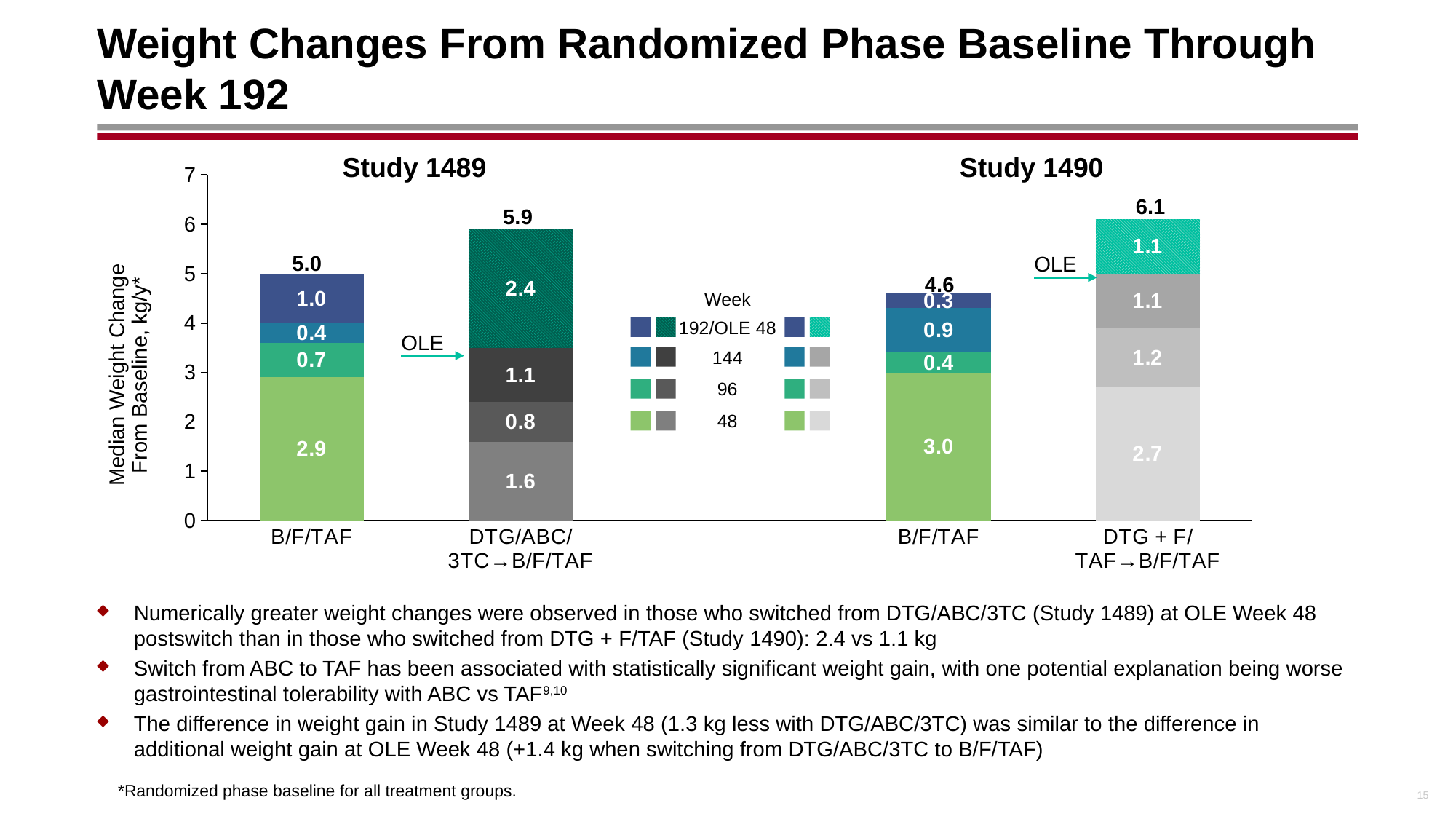
In the Study 1489 chart, what is the OLE Week 48 segment value for the DTG/ABC/3TC→B/F/TAF bar? 2.4 What type of chart is used on this slide? Stacked bar chart In the Study 1490 chart, what is the Week 144 segment value for the B/F/TAF bar? 0.9 In the Study 1490 chart, what is the Week 48 segment value for the B/F/TAF bar? 3.0 In the Study 1489 chart, what is the total median weight change for the B/F/TAF bar? 5.0 What is the y-axis label of the charts? Median Weight Change From Baseline, kg/y* In the Study 1489 chart, what is the Week 48 segment value for the DTG/ABC/3TC→B/F/TAF bar? 1.6 In the Study 1490 chart, which bar has the higher total median weight change? DTG + F/TAF→B/F/TAF In the Study 1490 chart, what is the total median weight change for the DTG + F/TAF→B/F/TAF bar? 6.1 In the Study 1489 chart, what is the difference between the total for DTG/ABC/3TC→B/F/TAF and the total for B/F/TAF? 0.9 In the Study 1489 chart, is the Week 192 segment for B/F/TAF larger or smaller than the Week 96 segment for B/F/TAF? larger How many week time points does the legend list? 4